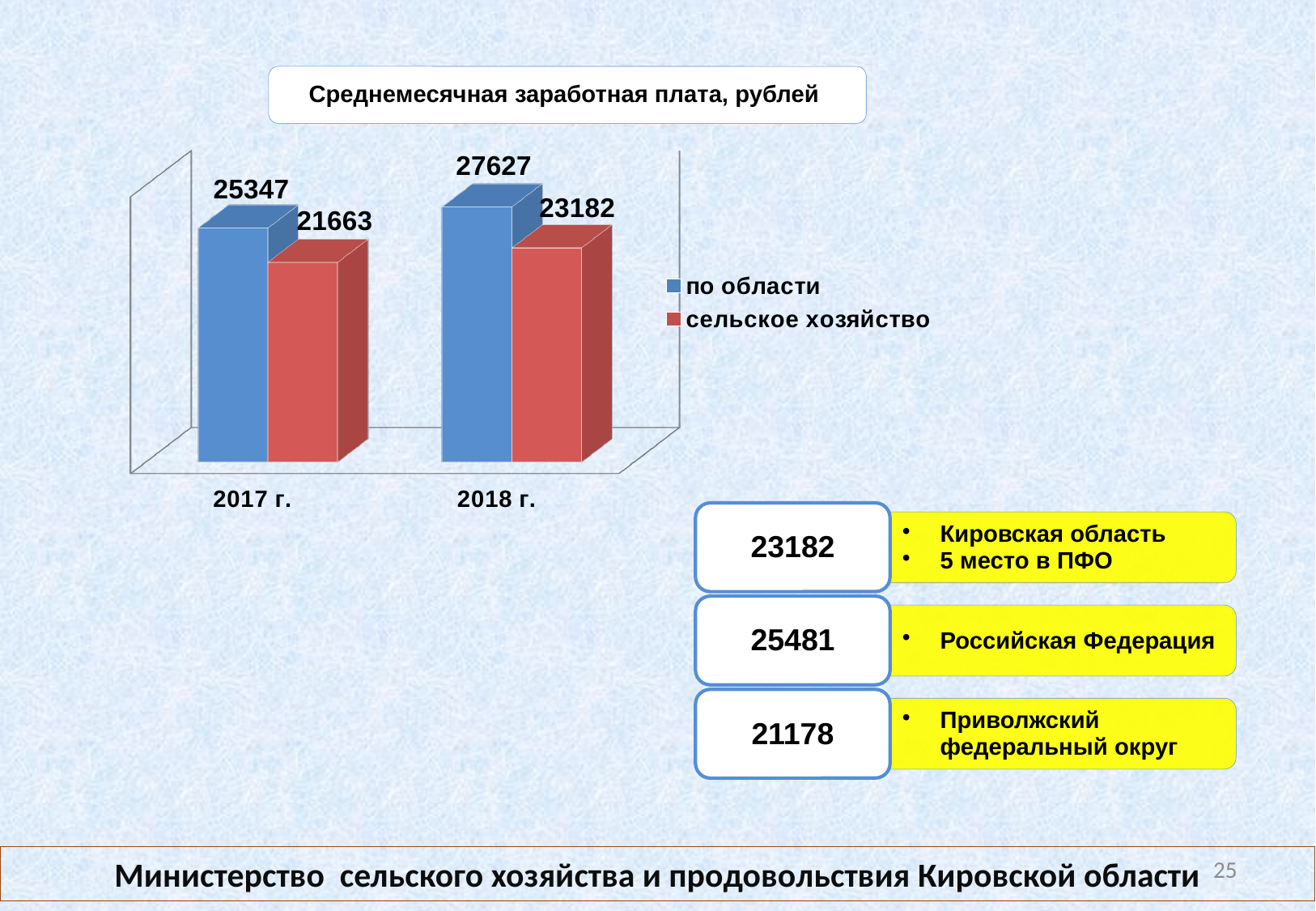
Which year has the highest value for "по области"? 2018 г. How many series does the legend list? 2 What is the value for "по области" in 2018 г.? 27627 Do the values for "по области" rise or fall from 2017 г. to 2018 г.? rise Which is larger in 2017 г.: "по области" or "сельское хозяйство"? по области What is the value for "сельское хозяйство" in 2018 г.? 23182 Which year has the lowest value for "сельское хозяйство"? 2017 г. What is the value for "по области" in 2017 г.? 25347 By how much did the "сельское хозяйство" value increase from 2017 г. to 2018 г.? 1519 What is the value for "сельское хозяйство" in 2017 г.? 21663 What kind of chart is shown on the slide? bar chart What is the difference between "по области" and "сельское хозяйство" in 2018 г.? 4445